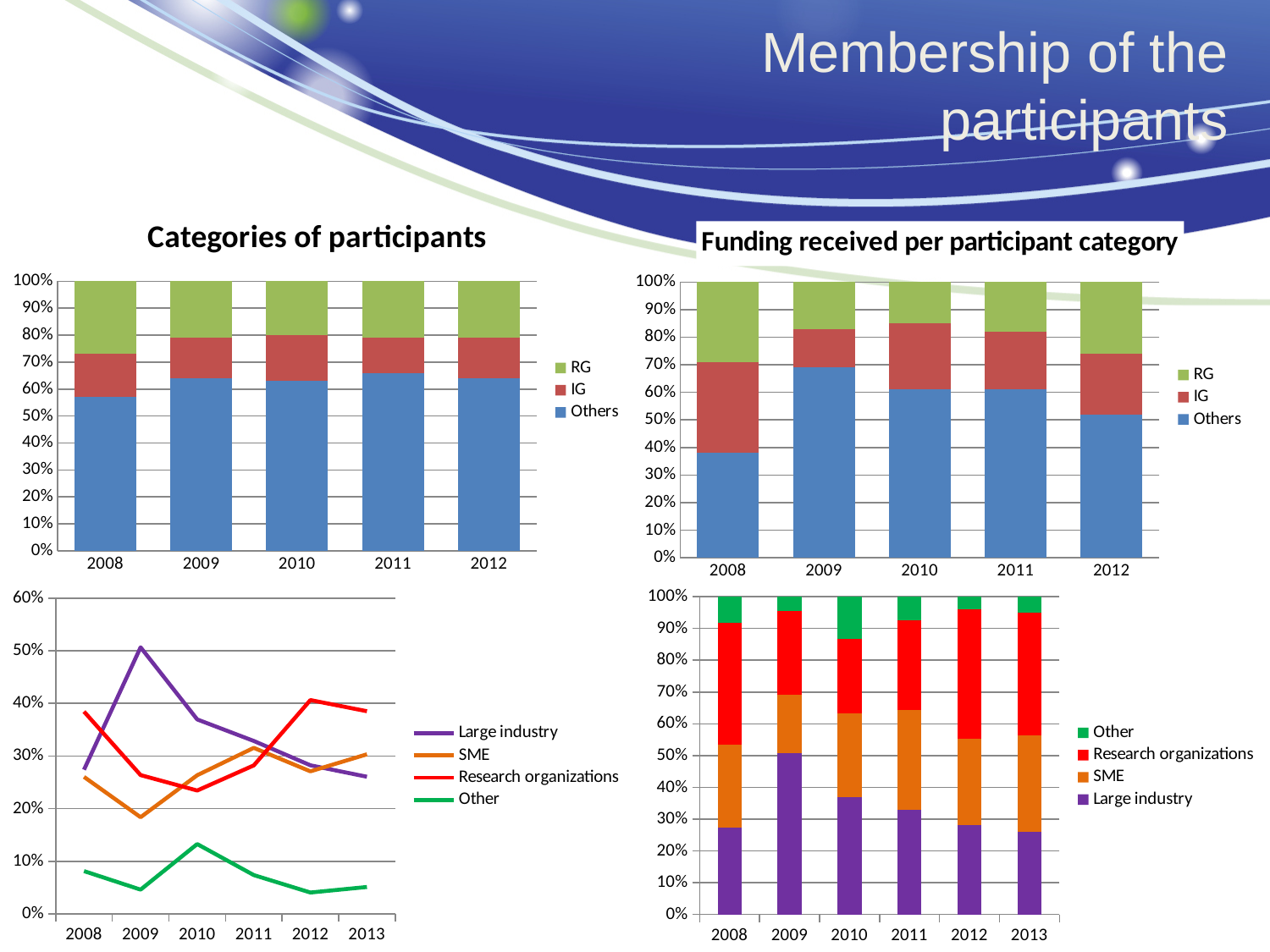
What type of chart is the 'Categories of participants' chart? bar chart In the bottom-left line chart, does the Large industry series rise or fall from 2009 to 2013? fall In the 'Funding received per participant category' chart, which year has the smallest share for Others? 2008 In the 'Categories of participants' chart, is the value for Others in 2008 greater or less than 50%? greater What type of chart is the bottom-left chart on the slide? line chart In the 'Funding received per participant category' chart, is the value for Others in 2008 greater or less than 50%? less In the bottom-left line chart, which series has the highest value in 2009? Large industry How many years are shown on the x axis of the 'Categories of participants' chart? 5 In the bottom-right stacked bar chart, is the value for Large industry in 2009 greater or less than 40%? greater How many series does the legend of the 'Categories of participants' chart list? 3 How many series does the legend of the bottom-left line chart list? 4